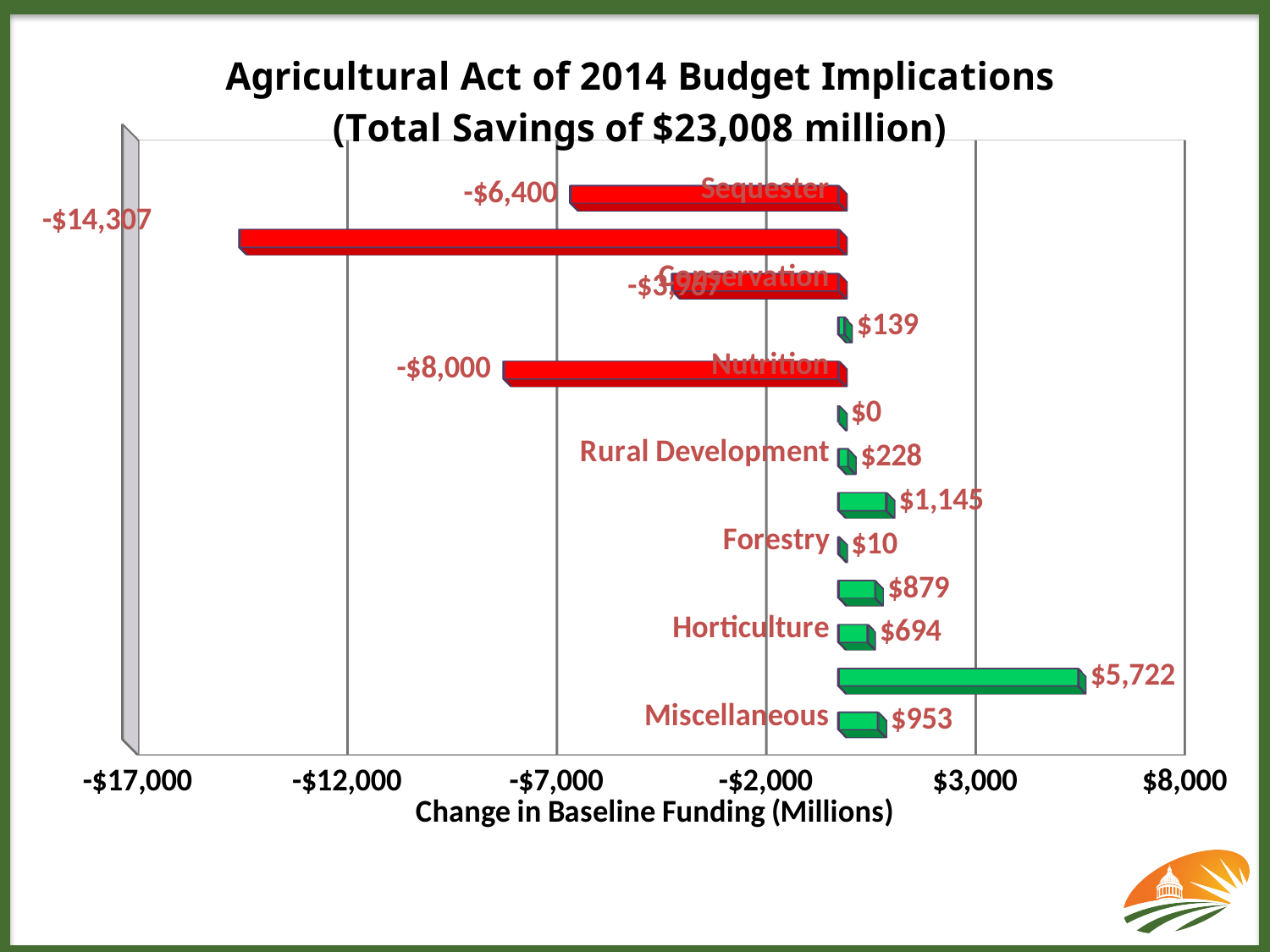
What is the value for Nutrition? -$8,000 What type of chart is shown on the slide? Bar chart What is the value for Sequester? -$6,400 What is the value for Rural Development? $228 What is the value for Forestry? $10 What is the lowest (most negative) value shown on the chart? -$14,307 What is the value for Horticulture? $694 What is the difference between the values for Nutrition and Sequester? $1,600 What is the title of the x axis? Change in Baseline Funding (Millions) What is the value for Miscellaneous? $953 What is the highest value shown on the chart? $5,722 Which is larger, the value for Horticulture or the value for Miscellaneous? Miscellaneous